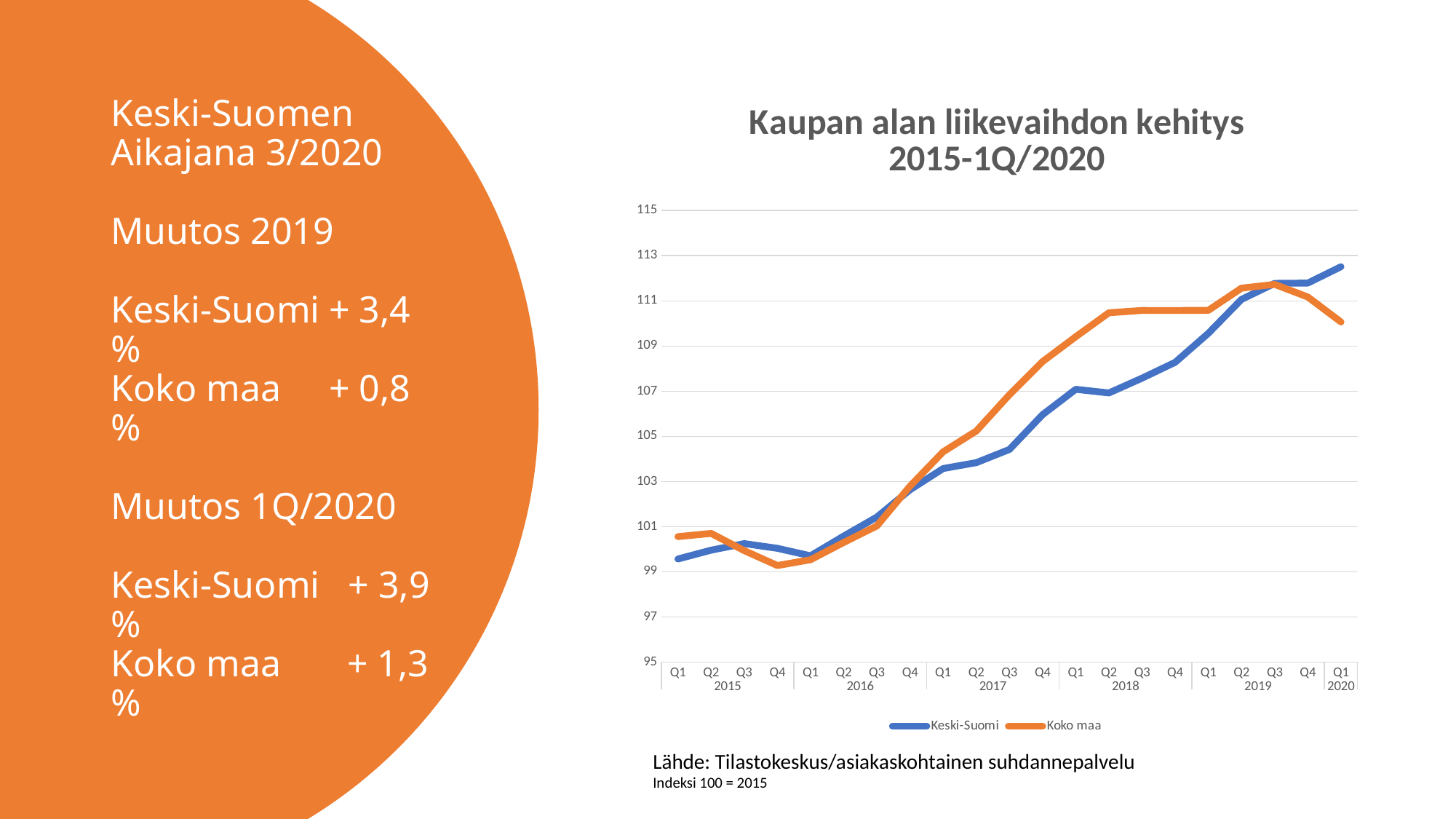
Is the Koko maa value for Q4 2015 greater or less than 101? less Is the Koko maa value for Q2 2018 greater or less than 109? greater What is the title of the chart? Kaupan alan liikevaihdon kehitys 2015-1Q/2020 Is the Keski-Suomi value for Q1 2020 greater or less than 111? greater What kind of chart is shown on the slide? line chart Does the Koko maa line rise or fall from Q3 2019 to Q1 2020? fall Does the Keski-Suomi line generally rise or fall from Q1 2015 to Q1 2020? rise How many quarterly points are plotted along the x axis for each series? 21 How many series does the chart legend list? 2 In Q2 2018, which series has the higher value, Keski-Suomi or Koko maa? Koko maa What are the two series named in the chart legend? Keski-Suomi and Koko maa In Q1 2020, which series has the higher value, Keski-Suomi or Koko maa? Keski-Suomi